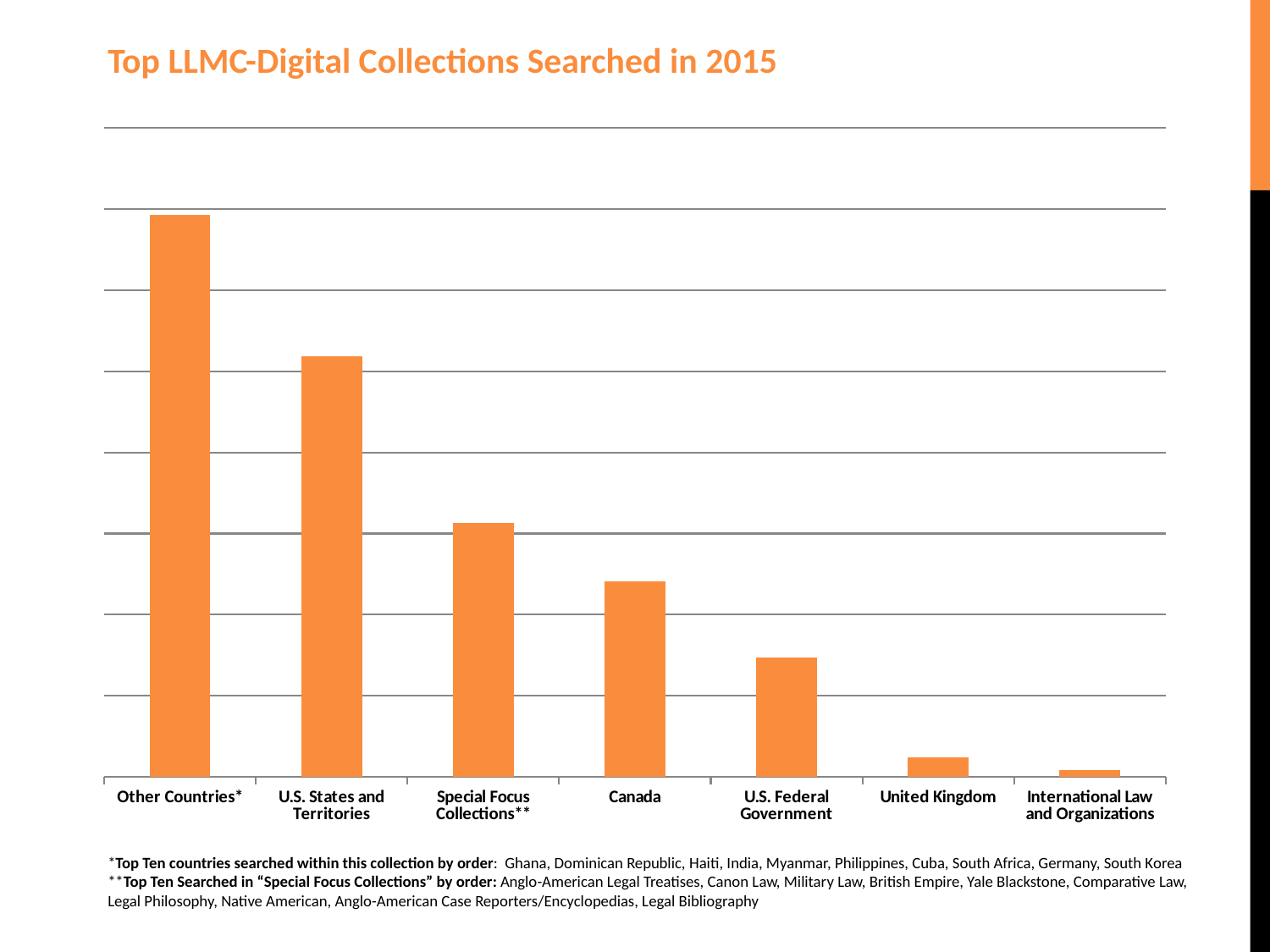
Which category has the highest bar? Other Countries* How many categories are shown on the x axis of the chart? 7 Which is larger, the bar for Canada or the bar for U.S. Federal Government? Canada Which is larger, the bar for United Kingdom or the bar for International Law and Organizations? United Kingdom Which category has the lowest bar? International Law and Organizations What colour are the bars in the chart? Orange Which is larger, the bar for U.S. States and Territories or the bar for Special Focus Collections**? U.S. States and Territories What is the title of the chart? Top LLMC-Digital Collections Searched in 2015 What type of chart is shown on the slide? Bar chart Which category has the second-highest bar? U.S. States and Territories Do the bar values rise or fall from left to right along the x axis? Fall